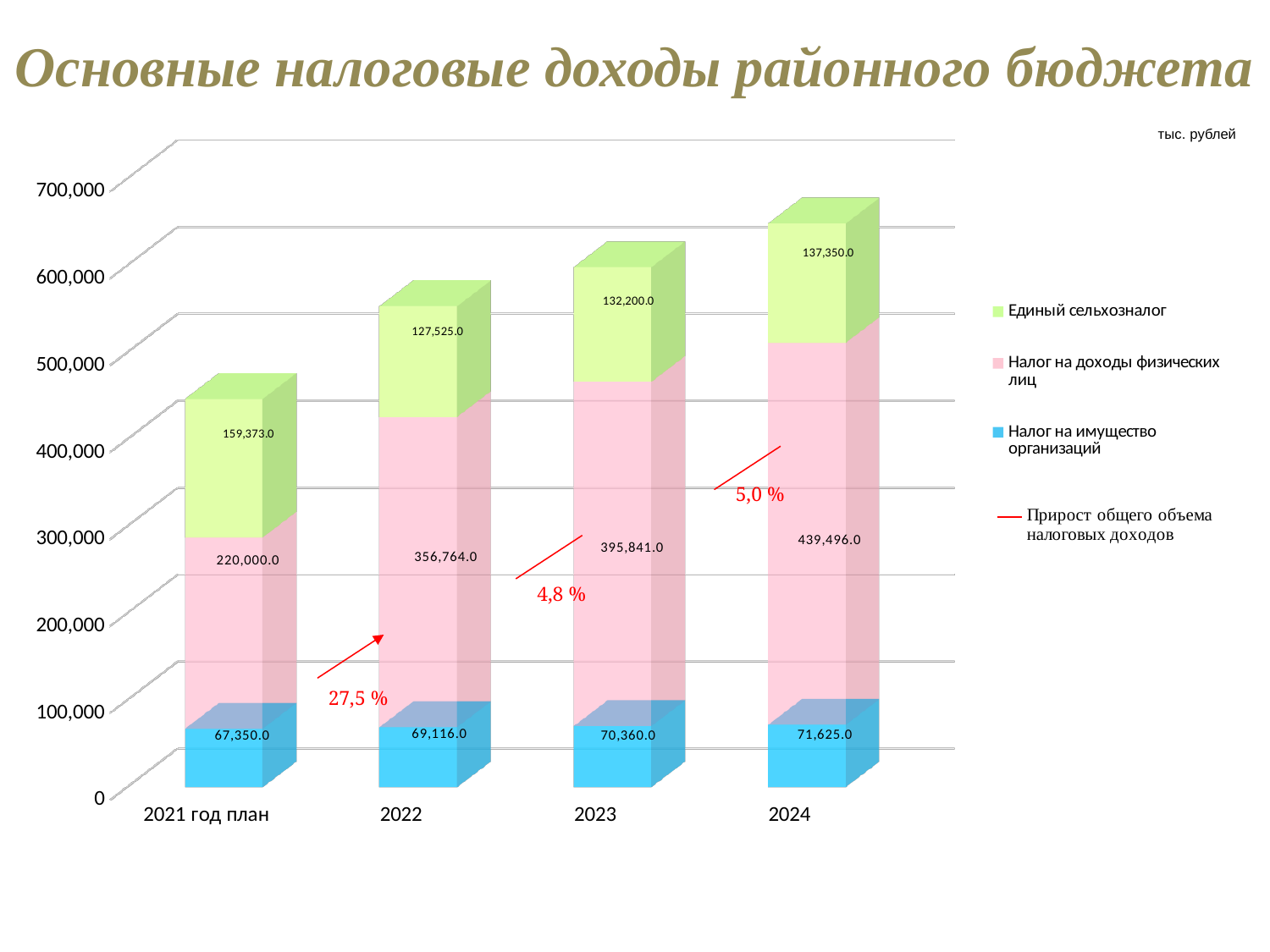
How many categories (years) are shown on the x axis? 4 What is the total of the stacked bar for 2024? 648,471.0 What is the value of Налог на имущество организаций for 2024? 71,625.0 In which year is Налог на имущество организаций the lowest? 2021 год план What is the difference between Налог на доходы физических лиц in 2024 and in 2021 год план? 219,496.0 Which is larger: Единый сельхозналог in 2022 or in 2023? 2023 How many entries does the legend list? 4 What is the value of Налог на доходы физических лиц for 2022? 356,764.0 In which year is Единый сельхозналог the highest? 2021 год план What type of chart is shown on the slide? stacked bar chart Does Налог на доходы физических лиц rise or fall from 2021 год план to 2024? rise What is the value of Единый сельхозналог for 2021 год план? 159,373.0